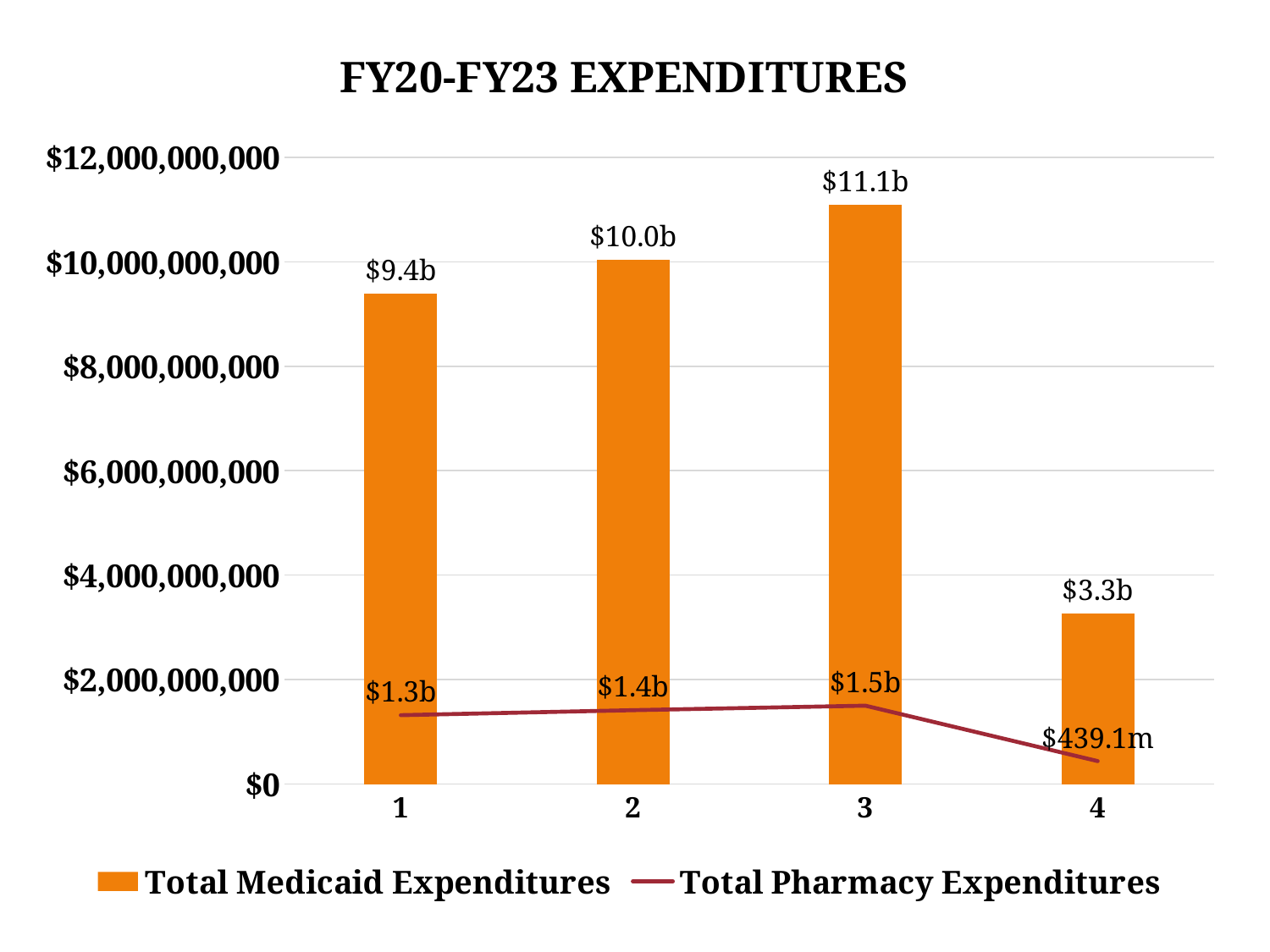
Is the Total Medicaid Expenditures value for category 2 greater or less than $8,000,000,000? greater What is the title of the chart? FY20-FY23 EXPENDITURES Which category has the lowest Total Pharmacy Expenditures? 4 How many series does the legend list? 2 What is the Total Medicaid Expenditures value for category 1? $9.4b What is the Total Pharmacy Expenditures value for category 4? $439.1m Is the Total Medicaid Expenditures value for category 4 greater or less than $4,000,000,000? less What is the Total Medicaid Expenditures value for category 3? $11.1b What is the Total Pharmacy Expenditures value for category 2? $1.4b How many categories are shown on the x axis? 4 Which category has the lowest Total Medicaid Expenditures? 4 Which category has the highest Total Medicaid Expenditures? 3